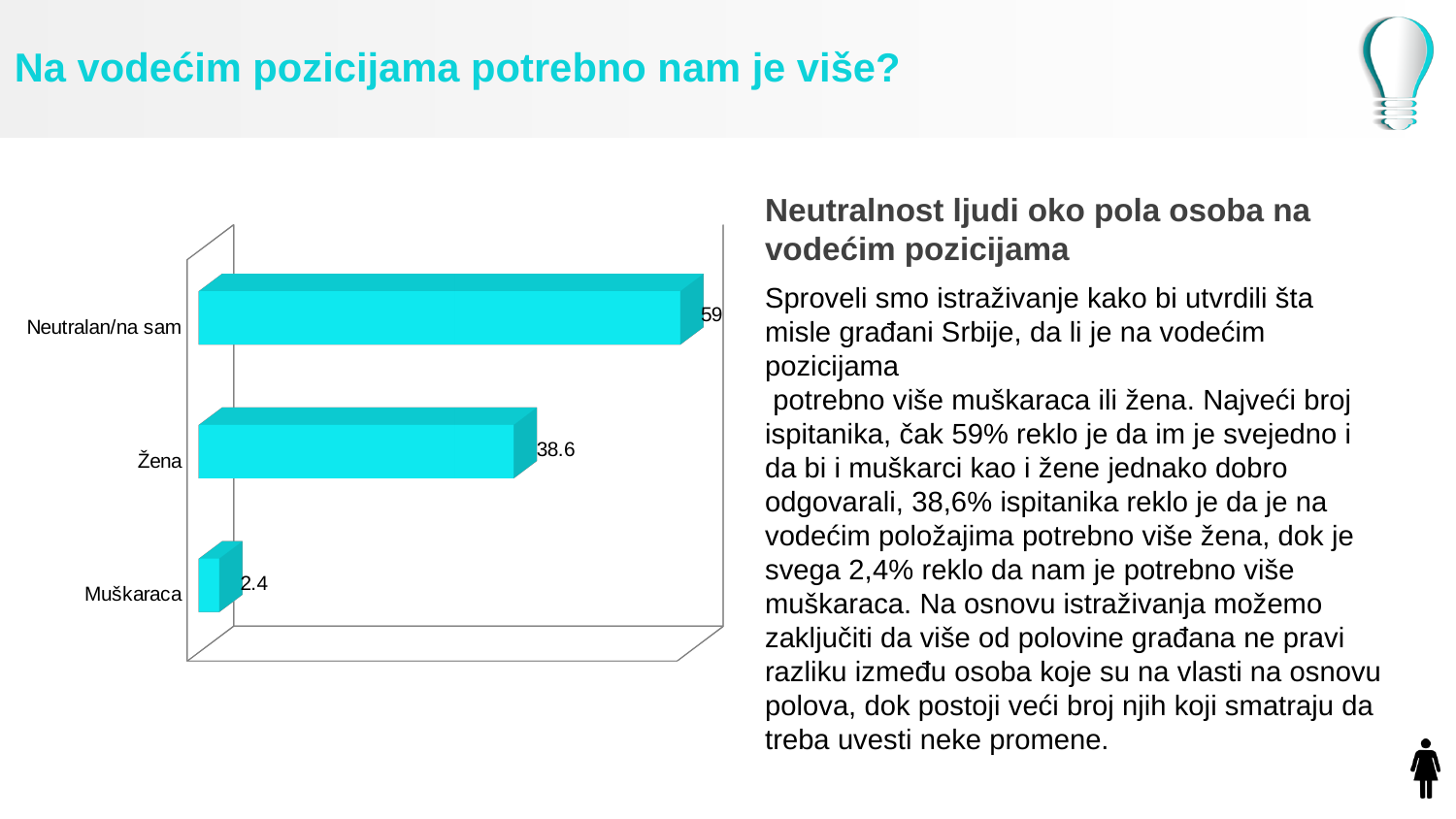
What is the difference between the values for Žena and Muškaraca? 36.2 What colour are the bars in the chart? Cyan What kind of chart is shown on the slide? Bar chart Which is larger, the value for Žena or the value for Muškaraca? Žena How many categories are shown in the chart? 3 What is the difference between the values for Neutralan/na sam and Žena? 20.4 Which category has the lowest value? Muškaraca Are the bars in the chart horizontal or vertical? Horizontal What is the value for Neutralan/na sam? 59 What is the value for Muškaraca? 2.4 What is the value for Žena? 38.6 Which category has the highest value? Neutralan/na sam